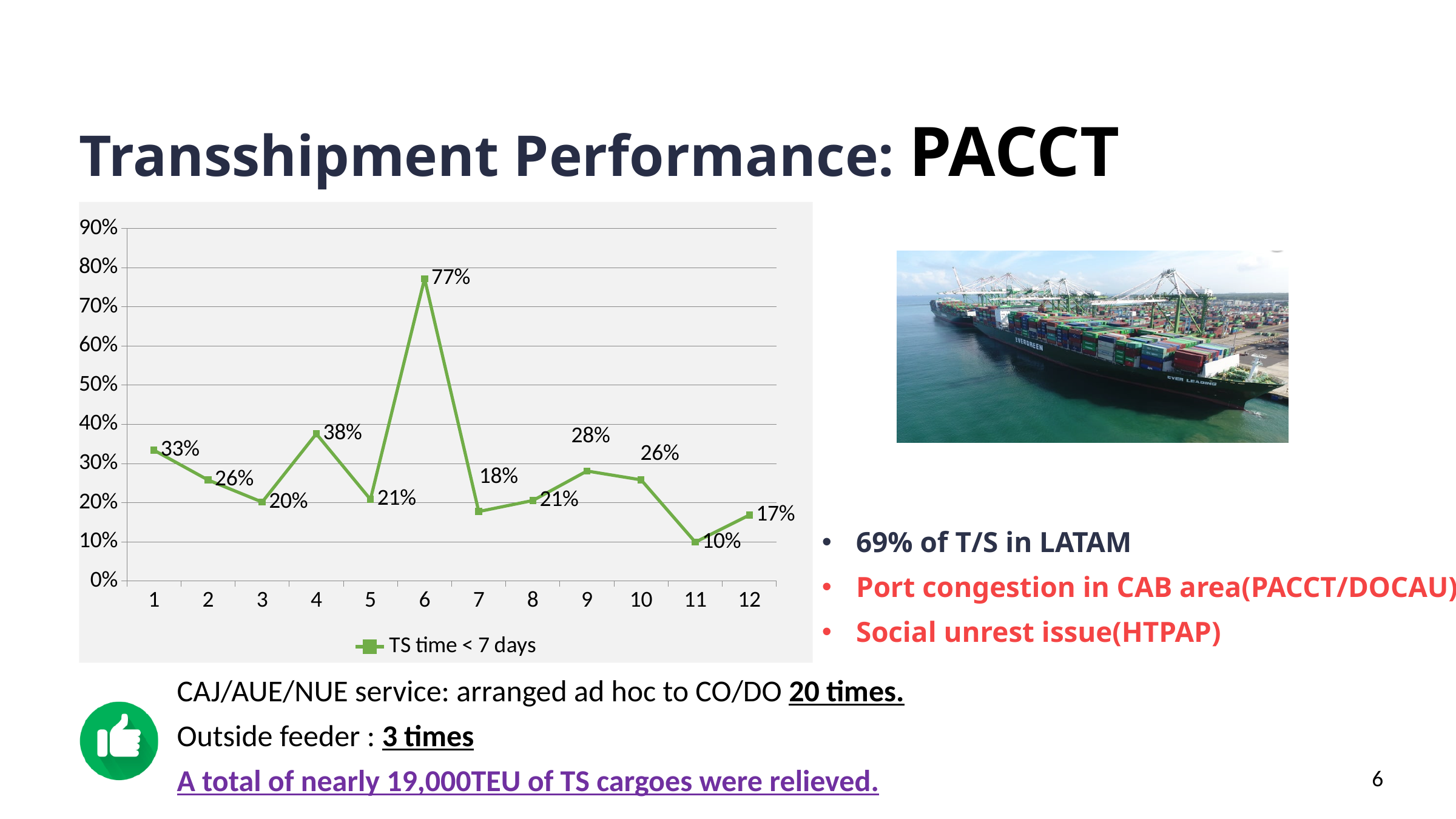
How many series does the legend list? 1 What kind of chart is shown on the slide? Line chart What is the value of TS time < 7 days at point 11? 10% At which x-axis point is TS time < 7 days highest? 6 What is the difference between the values at point 6 and point 7? 59% What is the value of TS time < 7 days at point 1? 33% Does the value rise or fall from point 9 to point 11? Fall How many data points are plotted on the line chart? 12 Which is larger, the value at point 4 or the value at point 9? Point 4 What is the value of TS time < 7 days at point 6? 77% What is the name of the series shown in the legend? TS time < 7 days At which x-axis point is TS time < 7 days lowest? 11